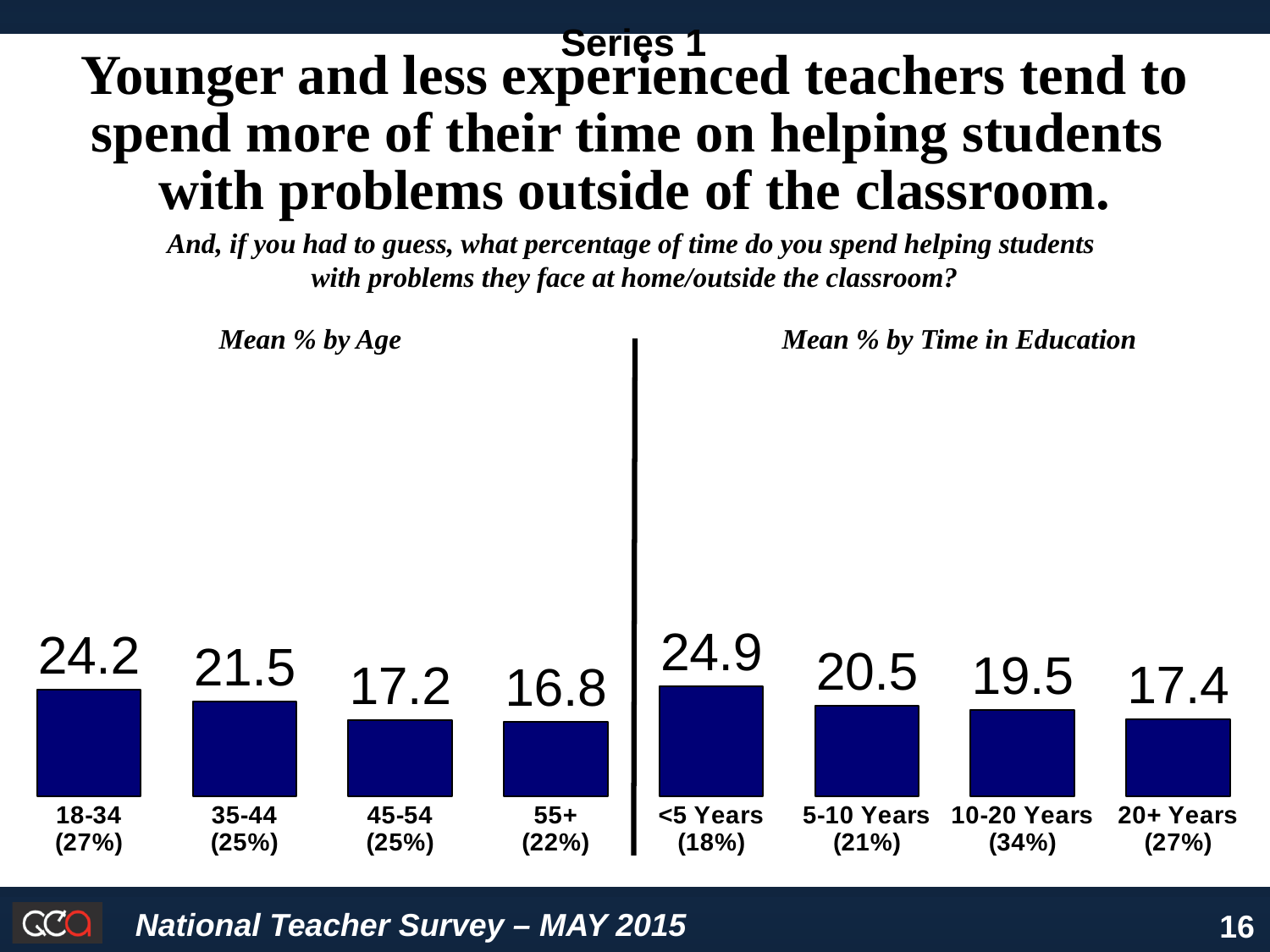
What is the value for the 18-34 age group? 24.2 What is the difference between the values for <5 Years and 20+ Years? 7.5 Do the values rise or fall from the 18-34 group to the 55+ group? Fall What is the value for the 55+ age group? 16.8 What is the value for teachers with 10-20 Years in education? 19.5 What is the heading above the right-hand group of bars? Mean % by Time in Education Which is larger, the value for 45-54 or the value for 5-10 Years? 5-10 Years What kind of chart is shown on the slide? Bar chart Which category has the highest value on the chart? <5 Years Which category has the lowest value on the chart? 55+ How many bars are plotted on the chart? 8 What is the difference between the values for 18-34 and 35-44? 2.7